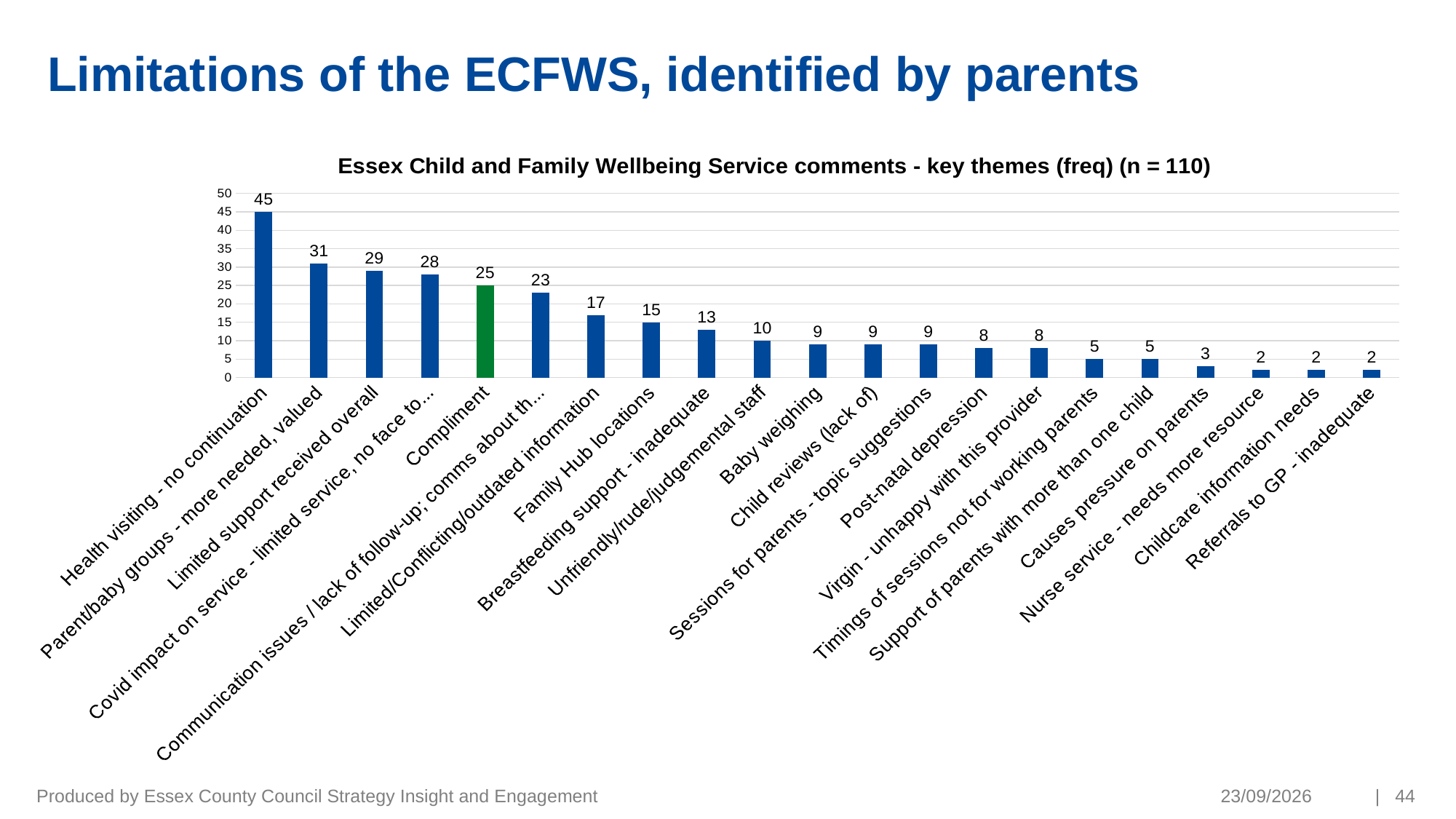
What is the difference between Limited/Conflicting/outdated information and Unfriendly/rude/judgemental staff? 7 What is the value for Family Hub locations? 15 What is the value for Health visiting - no continuation? 45 What kind of chart is this? Bar chart Which bar is coloured green rather than blue? Compliment Which is larger, Limited support received overall or Compliment? Limited support received overall What is the value for Breastfeeding support - inadequate? 13 Which category has the highest value? Health visiting - no continuation Do the values rise or fall from left to right along the x axis? Fall How many categories are shown in the chart? 21 What is the value for Compliment? 25 What is the difference between Health visiting - no continuation and Parent/baby groups - more needed, valued? 14